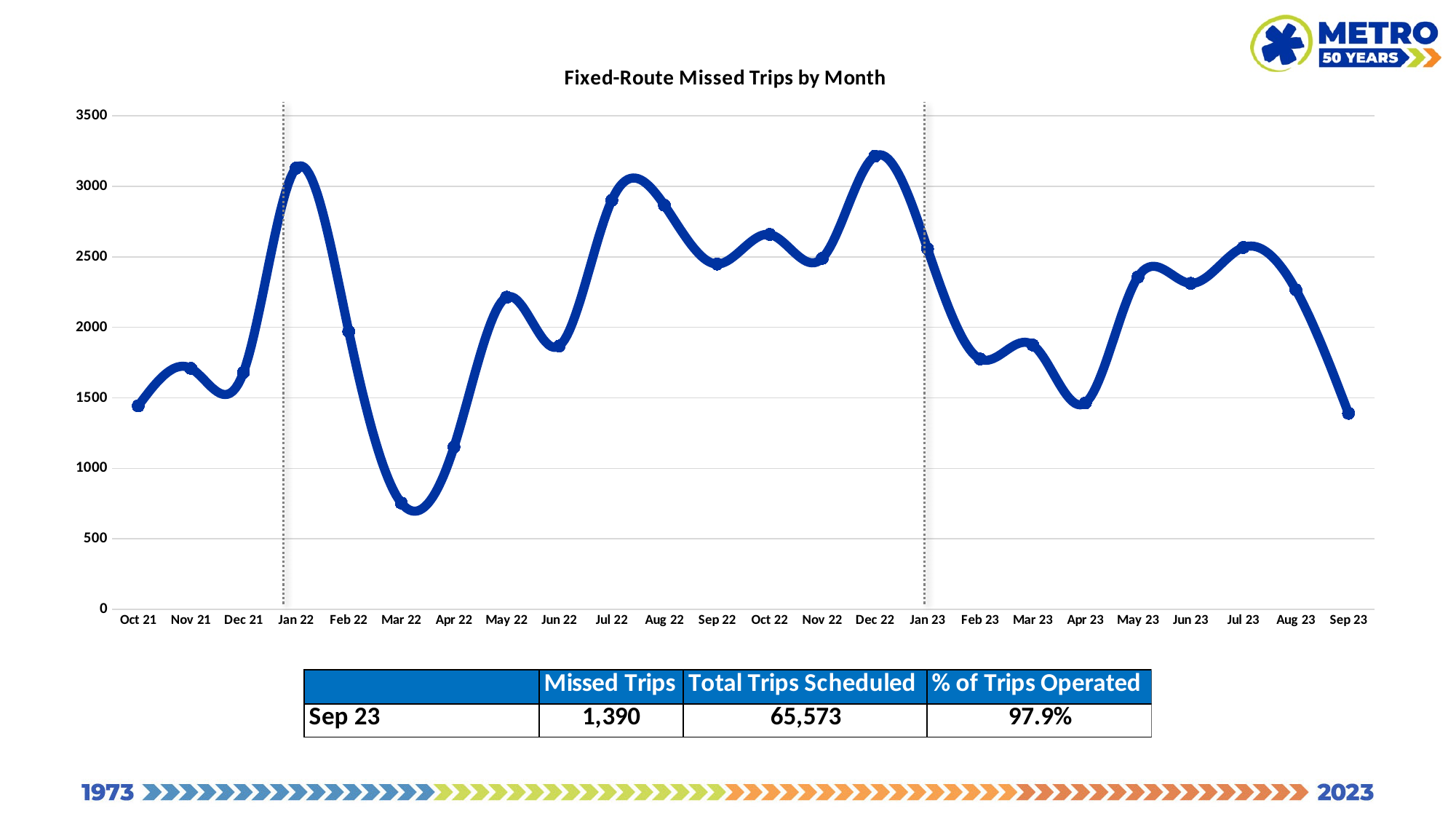
Which month has the highest number of missed trips? Dec 22 Which month has the lowest number of missed trips? Mar 22 Do missed trips rise or fall from Jul 23 to Sep 23? fall Is the value for Mar 22 greater or less than 1000? less What is the title of the chart? Fixed-Route Missed Trips by Month Which month has more missed trips, May 22 or Feb 23? May 22 Which month has more missed trips, Jul 22 or Jun 22? Jul 22 Is the value for Apr 23 greater or less than 2000? less How many missed trips were there in Sep 23? 1,390 How many months are plotted on the x axis of the chart? 24 Is the value for Jan 22 greater or less than 3000? greater What kind of chart is shown on the slide? line chart